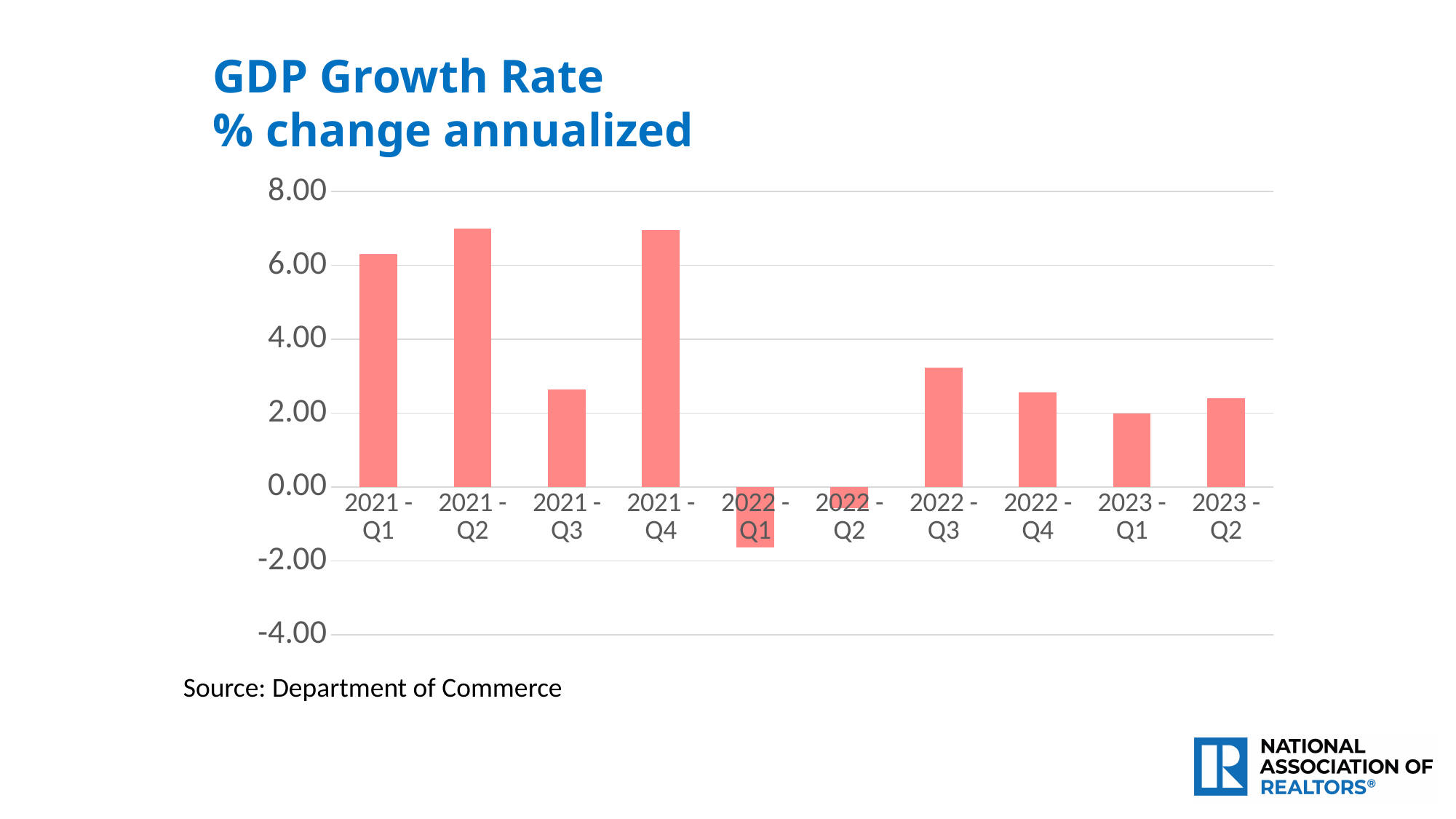
Is the value for 2021 - Q3 greater or less than 4.00? less What is the source cited below the chart? Department of Commerce Which is larger, the value for 2021 - Q1 or the value for 2021 - Q3? 2021 - Q1 Is the value for 2022 - Q1 greater or less than 0.00? less How many quarters show a negative GDP growth rate? 2 What kind of chart is shown on the slide? bar chart Is the value for 2022 - Q3 greater or less than 2.00? greater How many quarters are plotted on the chart? 10 Which is larger, the value for 2022 - Q3 or the value for 2023 - Q1? 2022 - Q3 Which quarter has the lowest GDP growth rate? 2022 - Q1